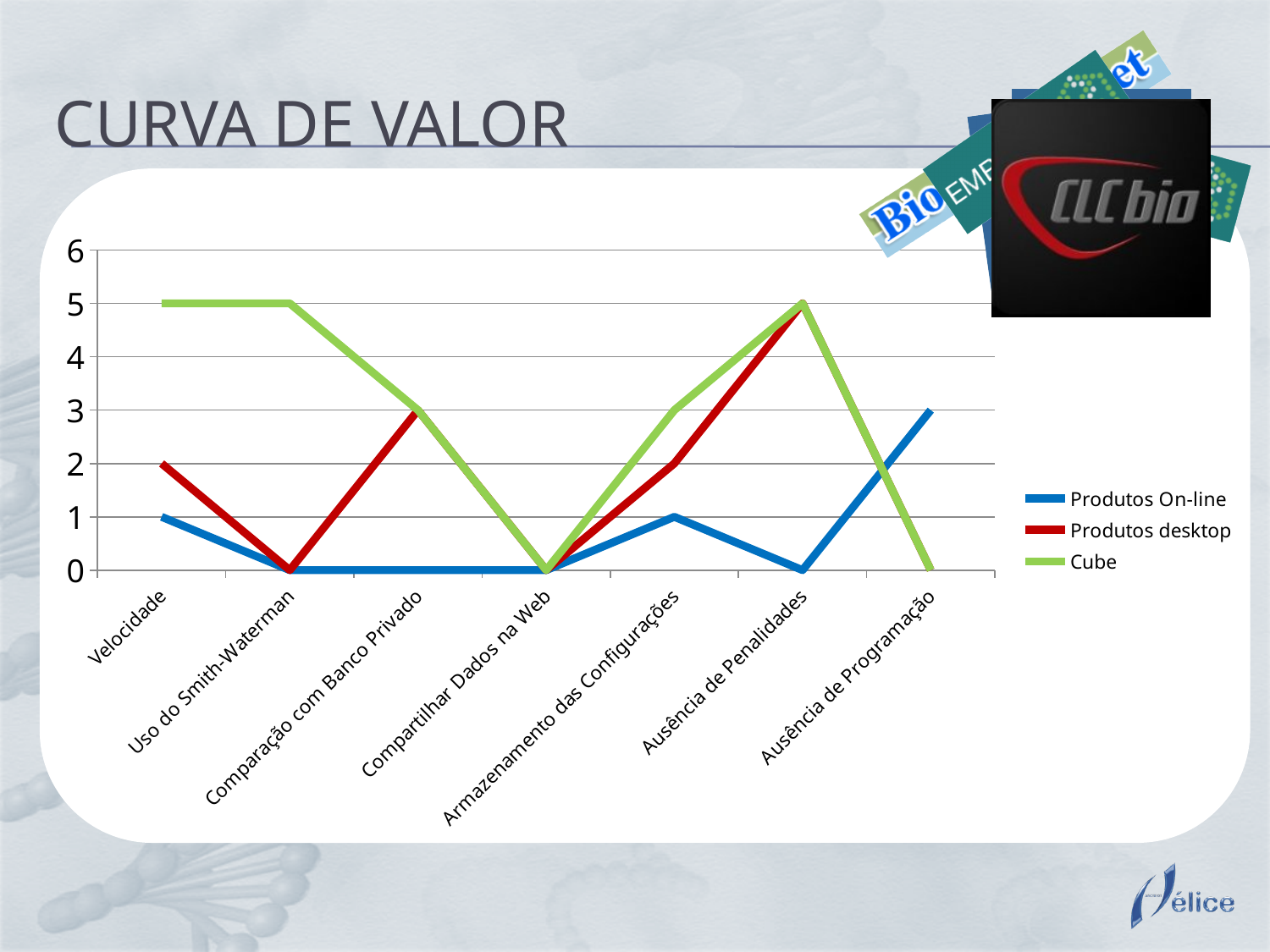
How many series does the legend list? 3 What is the difference between Cube and Produtos On-line for Velocidade? 4 What is the title of the slide containing the chart? CURVA DE VALOR What is the value of Produtos desktop for Ausência de Penalidades? 5 Which series has the highest value for Velocidade? Cube How many categories are shown on the x axis? 7 Which series has the lowest value for Armazenamento das Configurações? Produtos On-line For Ausência de Programação, which is larger: Produtos On-line or Cube? Produtos On-line What is the value of Produtos On-line for Ausência de Programação? 3 What is the value of Produtos desktop for Comparação com Banco Privado? 3 What kind of chart is shown on the slide? line chart What is the value of Cube for Velocidade? 5